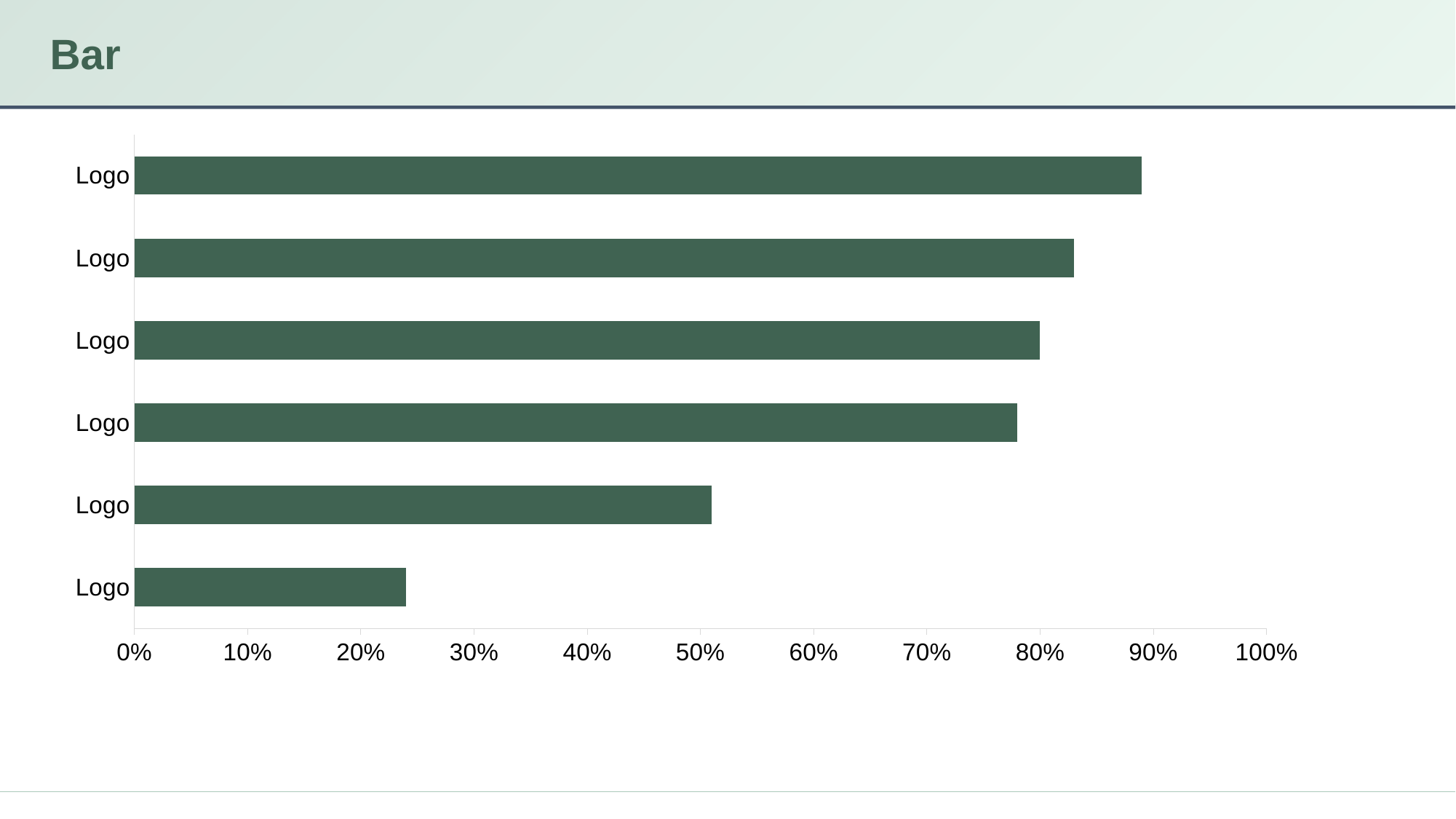
What is the title of the slide containing the chart? Bar Do the bar values increase or decrease going from the top bar to the bottom bar? decrease Is the value of the top bar greater or less than 80%? greater What label is used for every category on the vertical axis? Logo What kind of chart is shown on the slide? bar chart How many bars does the chart contain? 6 Which bar is the longest: the top bar or the bottom bar? the top bar Which bar has the highest value, by position? the top bar Is the value of the bottom bar greater or less than 30%? less Is the value of the second bar from the top greater or less than 90%? less Which bar has the lowest value, by position? the bottom bar